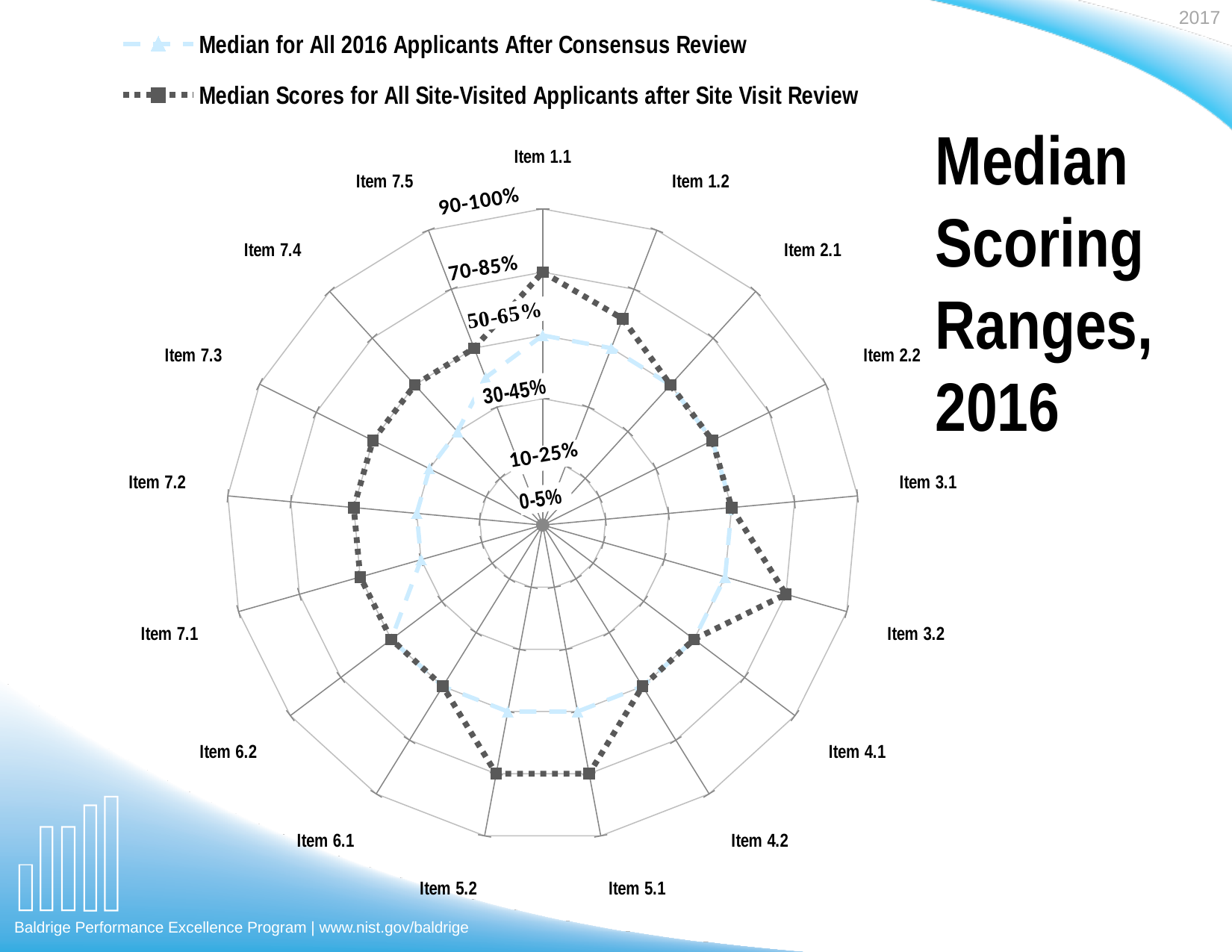
Which scoring range ring does the site-visit median for Item 5.1 land on? 70-85% For the site-visit median series, which is higher: Item 1.1 or Item 3.1? Item 1.1 For the site-visit median series, which is higher: Item 3.2 or Item 4.1? Item 3.2 Which scoring range ring does the consensus-review median for Item 1.1 land on? 50-65% Which scoring range ring does the site-visit median for Item 1.1 land on? 70-85% How many items (categories) are plotted around the radar chart? 17 For Item 1.1, which is higher: the median after consensus review or the median after site visit review? Median after site visit review What kind of chart is shown on the slide? Radar chart How many series does the legend list? 2 Which legend entry is drawn with the dark dashed line with square markers? Median Scores for All Site-Visited Applicants after Site Visit Review What is the title of the chart on the slide? Median Scoring Ranges, 2016